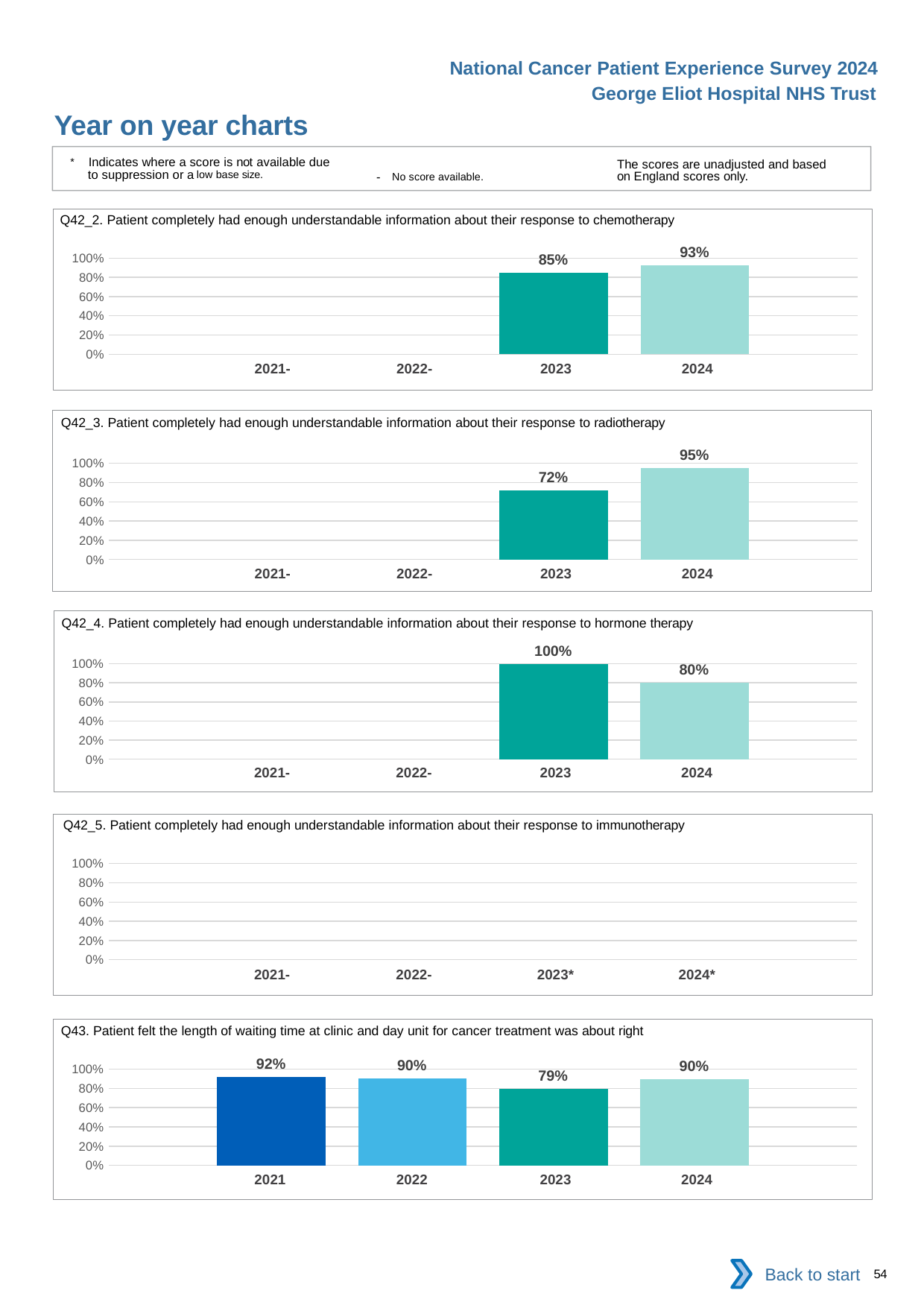
What type of chart is the Q43 chart (waiting time)? bar chart In the Q42_3 chart (radiotherapy), which year has the higher value, 2023 or 2024? 2024 In the Q42_5 chart (immunotherapy), how many bars are plotted? 0 In the Q43 chart (waiting time), which year has the highest value? 2021 In the Q43 chart (waiting time), what is the difference between the 2021 and 2023 values? 13% In the Q42_2 chart (chemotherapy), what is the difference between the 2024 and 2023 values? 8% In the Q42_4 chart (hormone therapy), do the values rise or fall from 2023 to 2024? fall In the Q42_3 chart (radiotherapy), what is the value for 2023? 72% In the Q42_4 chart (hormone therapy), what is the value for 2023? 100% In the Q42_2 chart (chemotherapy), what is the value for 2024? 93% In the Q43 chart (waiting time), which year has the lowest value? 2023 In the Q43 chart (waiting time), how many years have a plotted bar? 4